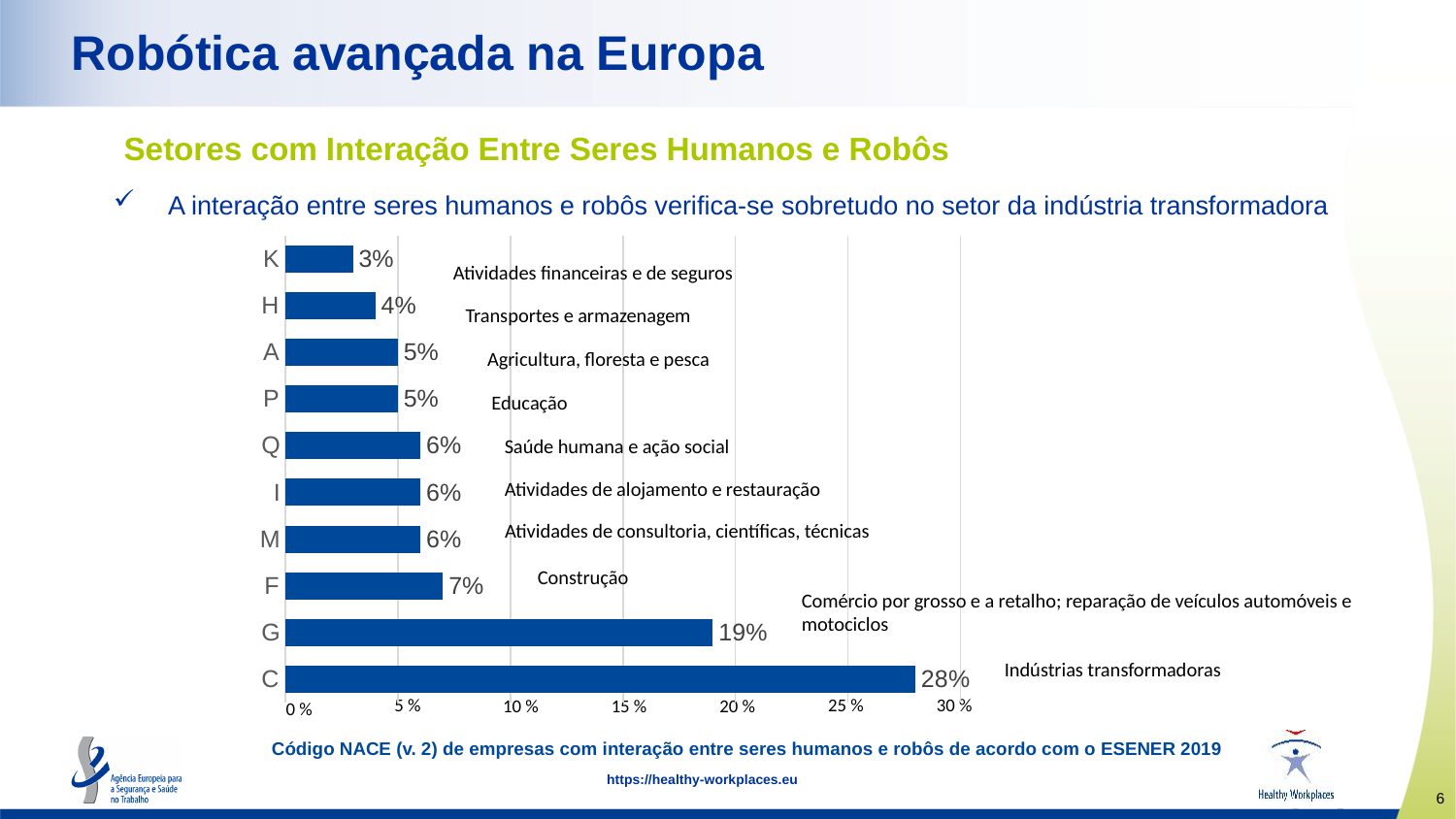
What is the value for category K (Atividades financeiras e de seguros)? 3% Which category has the lowest value? K How many categories are shown in the chart? 10 What kind of chart is shown on the slide? Bar chart Which category has the highest value? C What is the value for category C (Indústrias transformadoras)? 28% What is the difference between the values for F and H? 3% Which is larger, the value for G or the value for F? G What is the value for category G (Comércio por grosso e a retalho)? 19% What is the value for category F (Construção)? 7% What is the difference between the values for C and G? 9% Is the value for C greater or less than 25%? greater